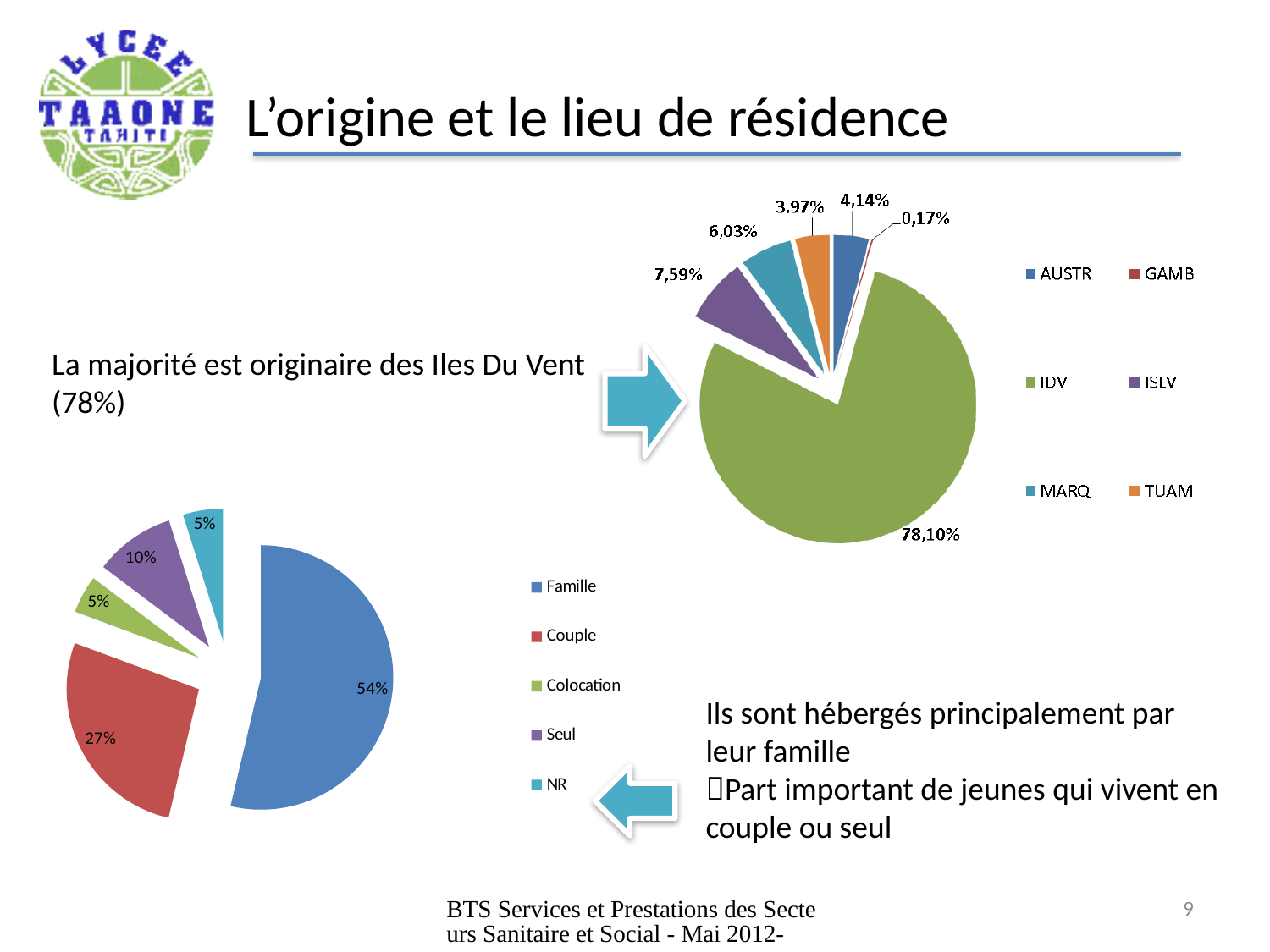
In the pie chart at the bottom left of the slide, which category has the largest share? Famille In the pie chart at the bottom left of the slide, what is the difference between the Famille share and the Couple share? 27% In the pie chart at the bottom left of the slide, what share is labelled for Couple? 27% In the pie chart at the top right of the slide, which category has the smallest share? GAMB In the pie chart at the top right of the slide, what share is labelled for ISLV? 7,59% In the pie chart at the bottom left of the slide, what share is labelled for Famille? 54% In the pie chart at the top right of the slide, which category has the largest share? IDV In the pie chart at the top right of the slide, what share is labelled for IDV? 78,10% In the pie chart at the top right of the slide, how many categories does the legend list? 6 In the pie chart at the top right of the slide, which is larger, the share for MARQ or the share for TUAM? MARQ What type of chart is shown at the bottom left of the slide? Pie chart In the pie chart at the bottom left of the slide, how many categories does the legend list? 5